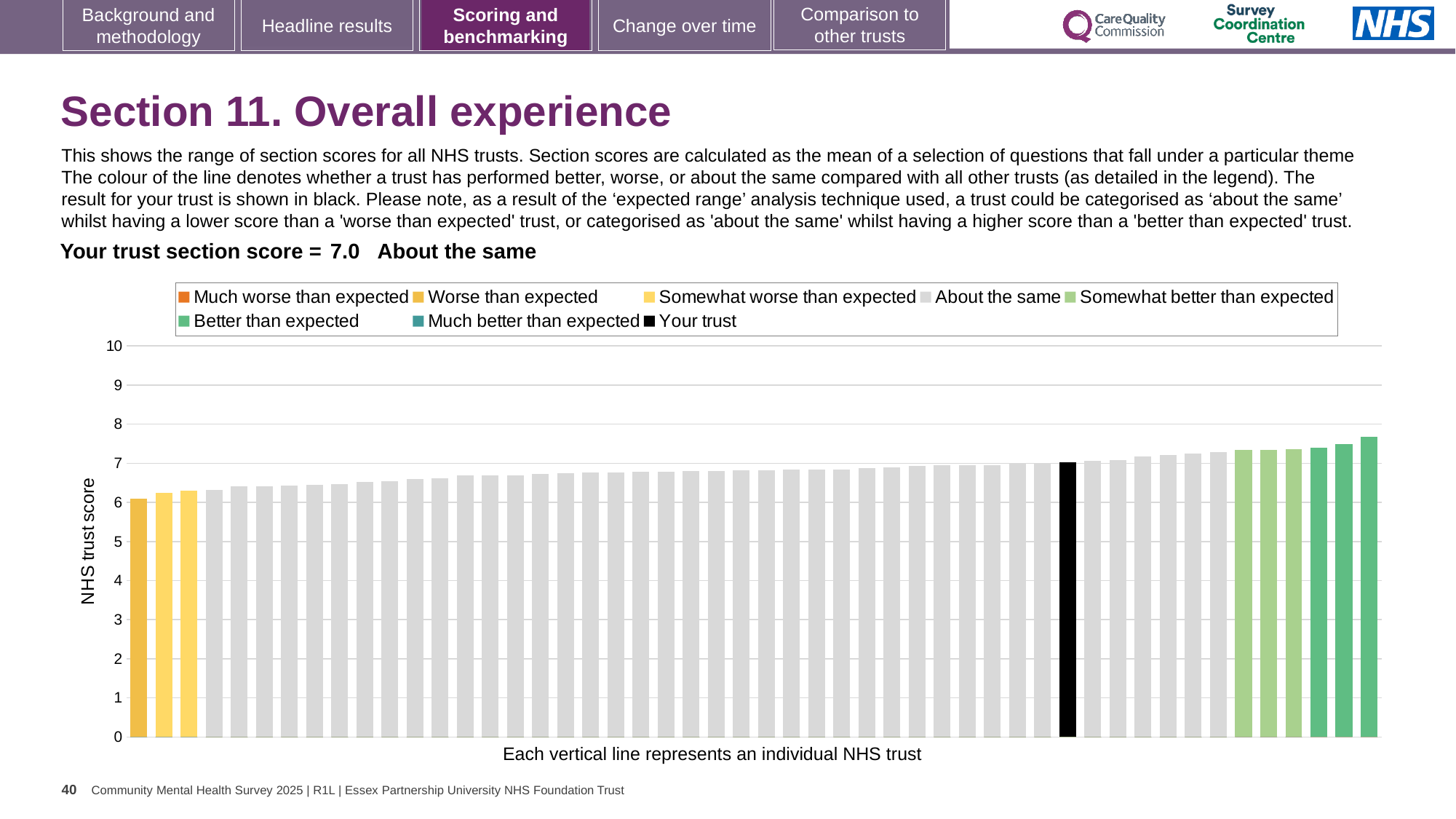
Do the bar values rise or fall from left to right along the x axis? Rise Is the value for the leftmost bar (the lowest trust) greater or less than 7? less What colour is the bar representing your trust? Black What is the section score for your trust shown on the slide? 7.0 Is the value for the rightmost bar greater or less than 8? less Which category is your trust placed in for this section? About the same Is the value for the rightmost bar (the highest trust) greater or less than 7? greater How many entries does the chart legend list? 8 What kind of chart is shown on the slide? Bar chart What is the label on the vertical axis of the chart? NHS trust score Which is larger: the bar for your trust or the leftmost bar? The bar for your trust